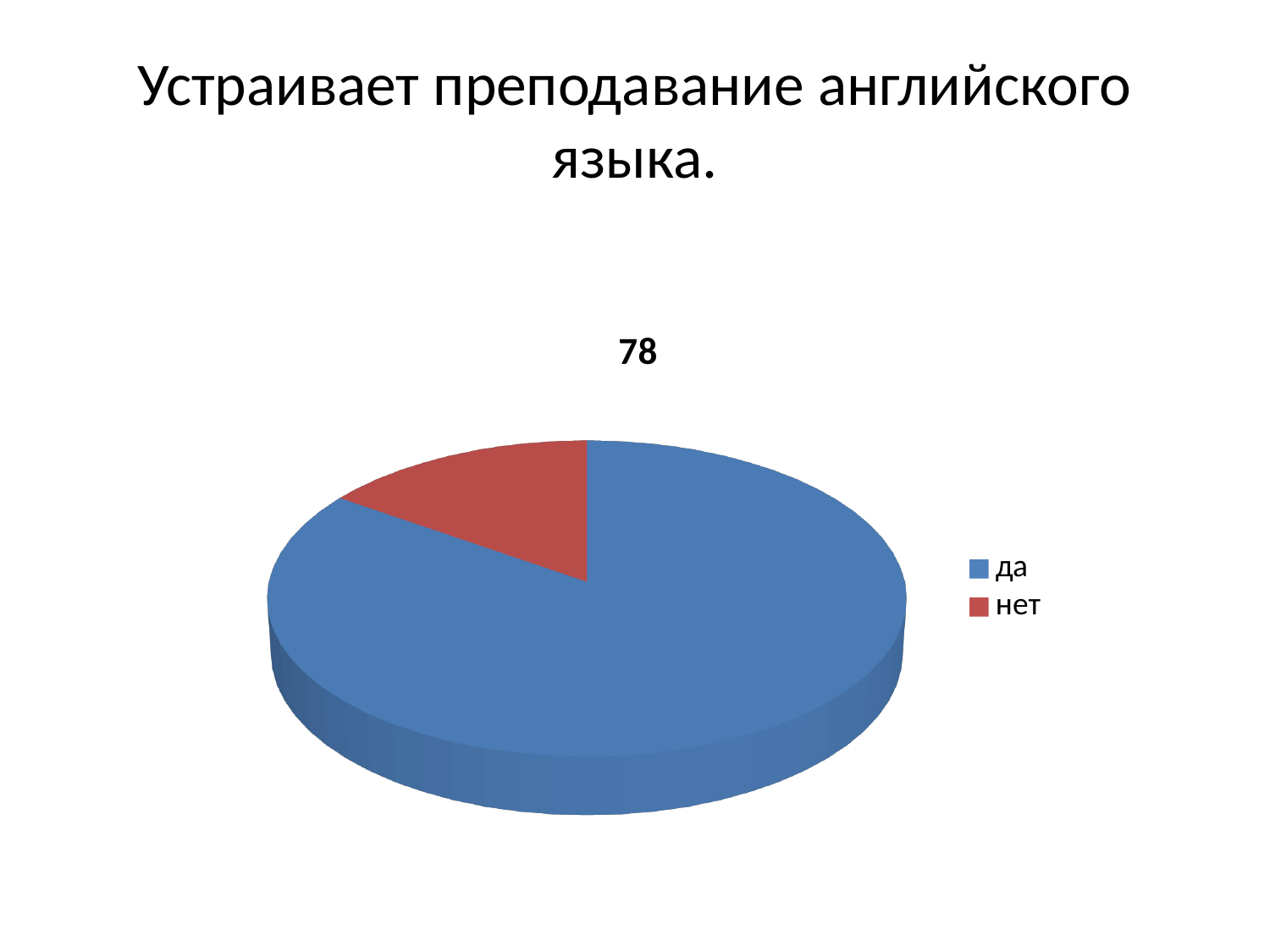
What is the title shown above the pie chart? 78 What kind of chart is shown on the slide? pie chart Which category has the largest slice in the pie chart? да How many entries does the legend of the pie chart list? 2 Which slice is larger in the pie chart, да or нет? да What colour is the slice for нет in the pie chart? red How many slices does the pie chart have? 2 Which category has the smallest slice in the pie chart? нет